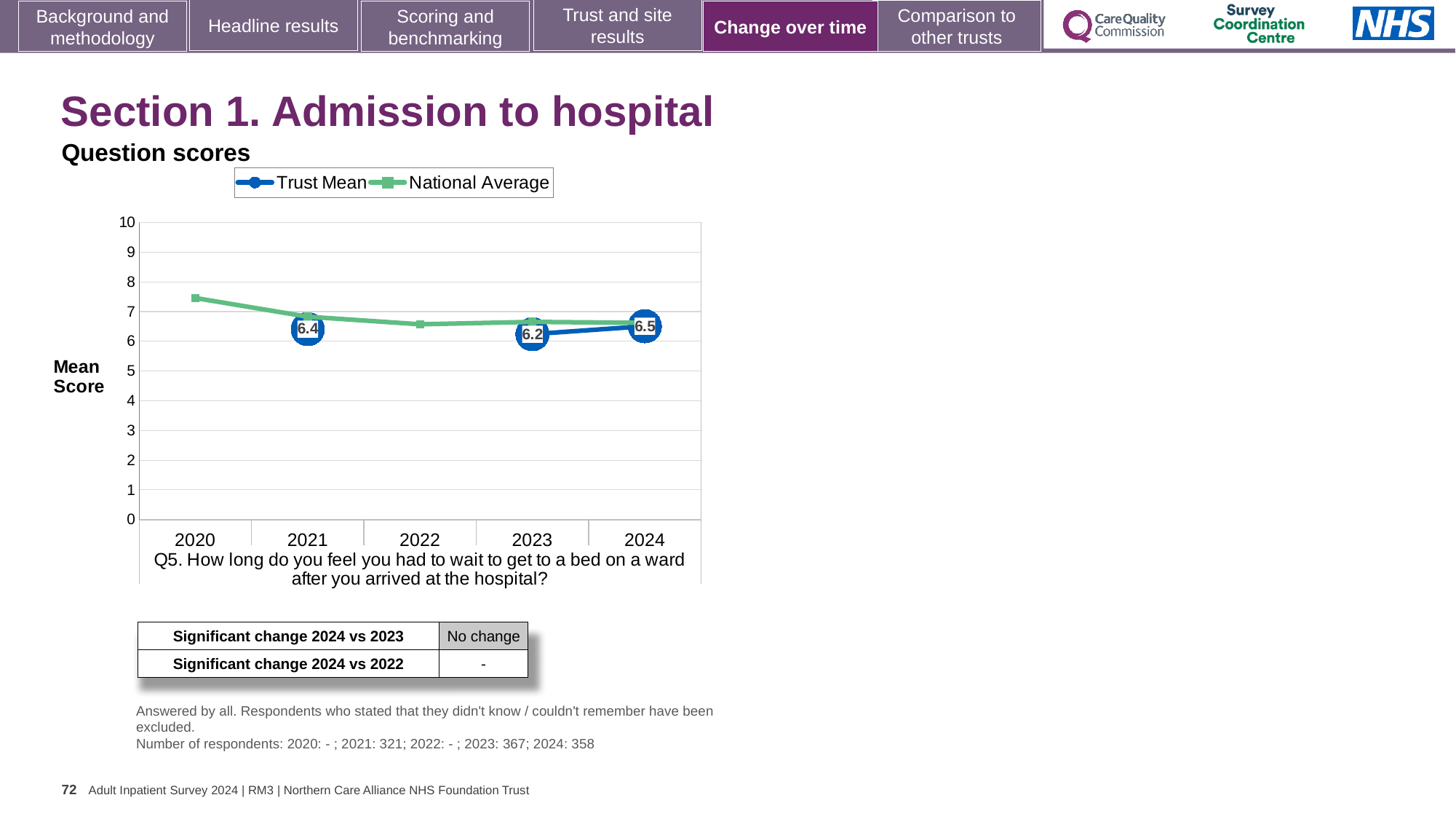
How many years are shown on the x axis of the chart? 5 In which year is the labelled Trust Mean score lowest? 2023 Which is larger, the Trust Mean score in 2021 or in 2024? 2024 What kind of chart is shown on the slide? Line chart Is the National Average value for 2022 greater or less than 7? less What is the Trust Mean score for 2023? 6.2 What is the Trust Mean score for 2024? 6.5 How many series does the chart legend list? 2 In which year is the labelled Trust Mean score highest? 2024 What is the difference between the Trust Mean score in 2024 and in 2023? 0.3 What is the Trust Mean score for 2021? 6.4 Is the National Average value for 2020 greater or less than 7? greater